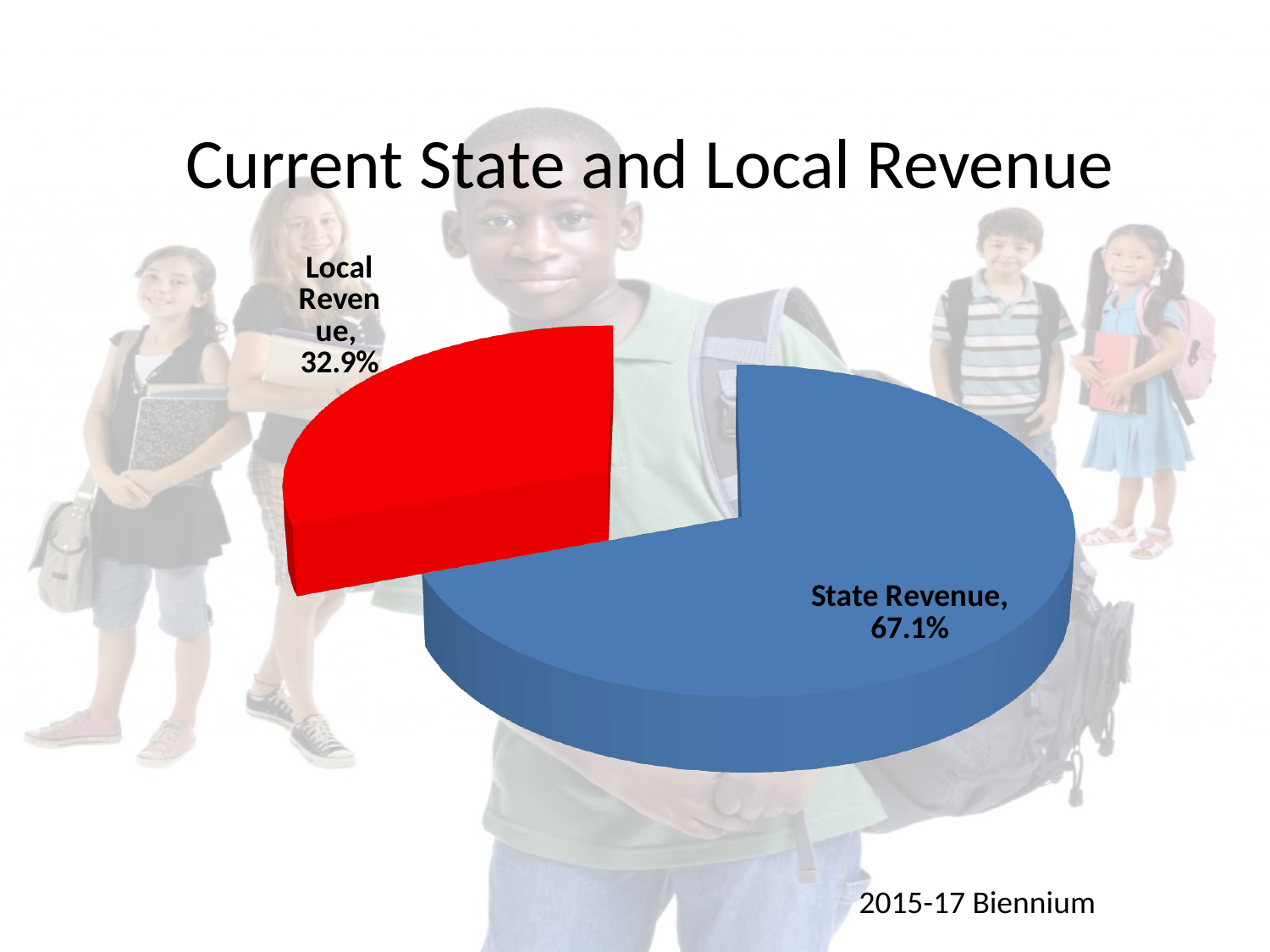
Which slice is the largest? State Revenue Is the share for Local Revenue greater or less than 50%? less What share of the pie does State Revenue represent? 67.1% What share of the pie does Local Revenue represent? 32.9% Which slice is the smallest? Local Revenue What is the difference in percentage points between State Revenue and Local Revenue? 34.2 How many slices does the pie chart have? 2 What kind of chart is shown on the slide? Pie chart Which is larger, State Revenue or Local Revenue? State Revenue What is the title of the slide containing the chart? Current State and Local Revenue What colour is the State Revenue slice? Blue What is the combined share of State Revenue and Local Revenue? 100%